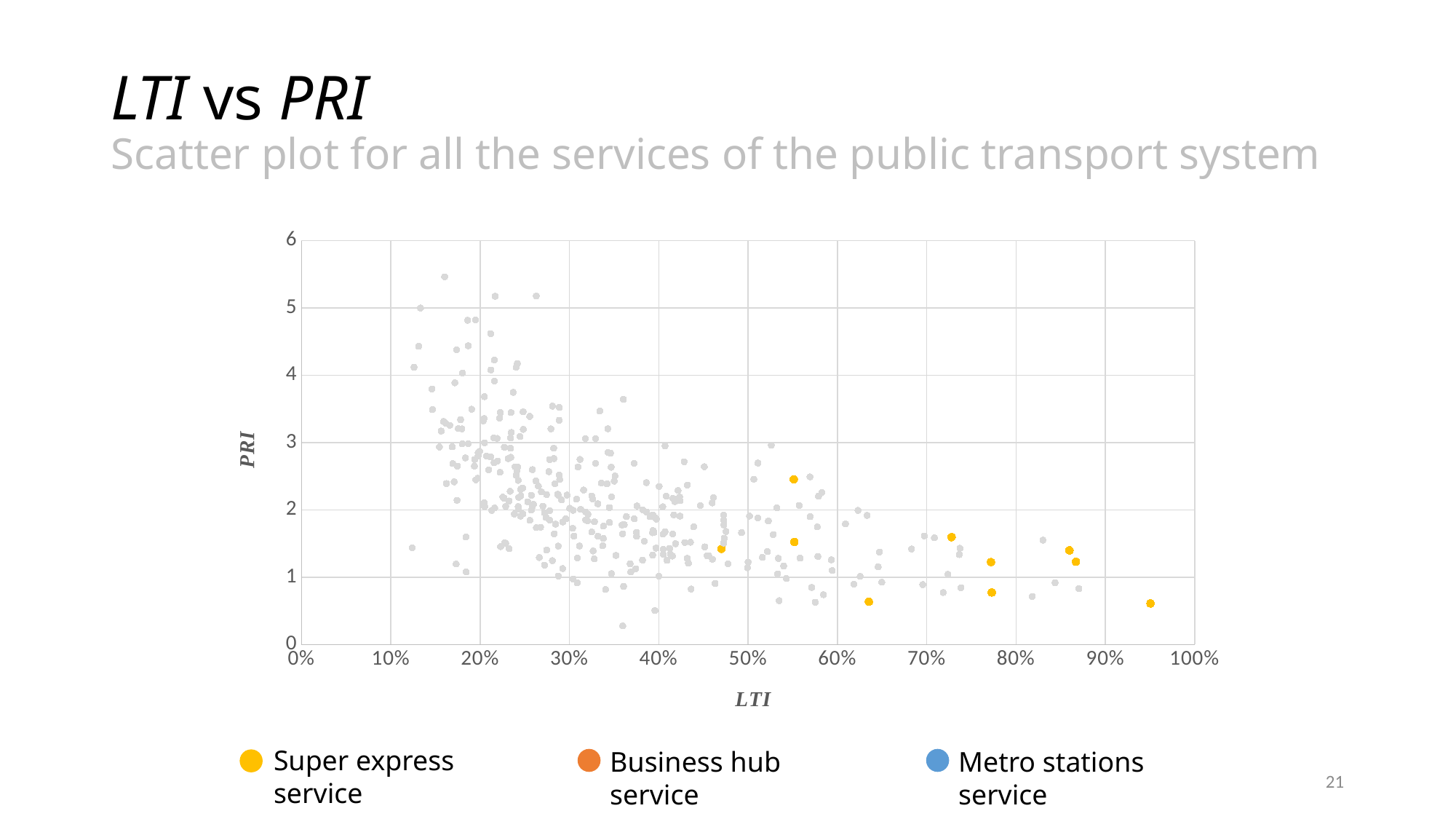
Is the PRI value of the highest point on the chart greater or less than 5? greater As LTI increases along the x axis, do the PRI values generally rise or fall? Fall What is the highest value shown on the vertical (PRI) axis? 6 How many services does the legend below the chart list? 3 What is the title of the chart on the slide? LTI vs PRI What kind of chart is shown on the slide? Scatter plot What is the label of the vertical axis? PRI Is the PRI value of the highest yellow (Super express service) point greater or less than 2? greater Which legend entry is shown in yellow? Super express service Is the LTI value of the rightmost yellow (Super express service) point greater or less than 90%? greater What is the label of the horizontal axis? LTI What is the highest value shown on the horizontal (LTI) axis? 100%